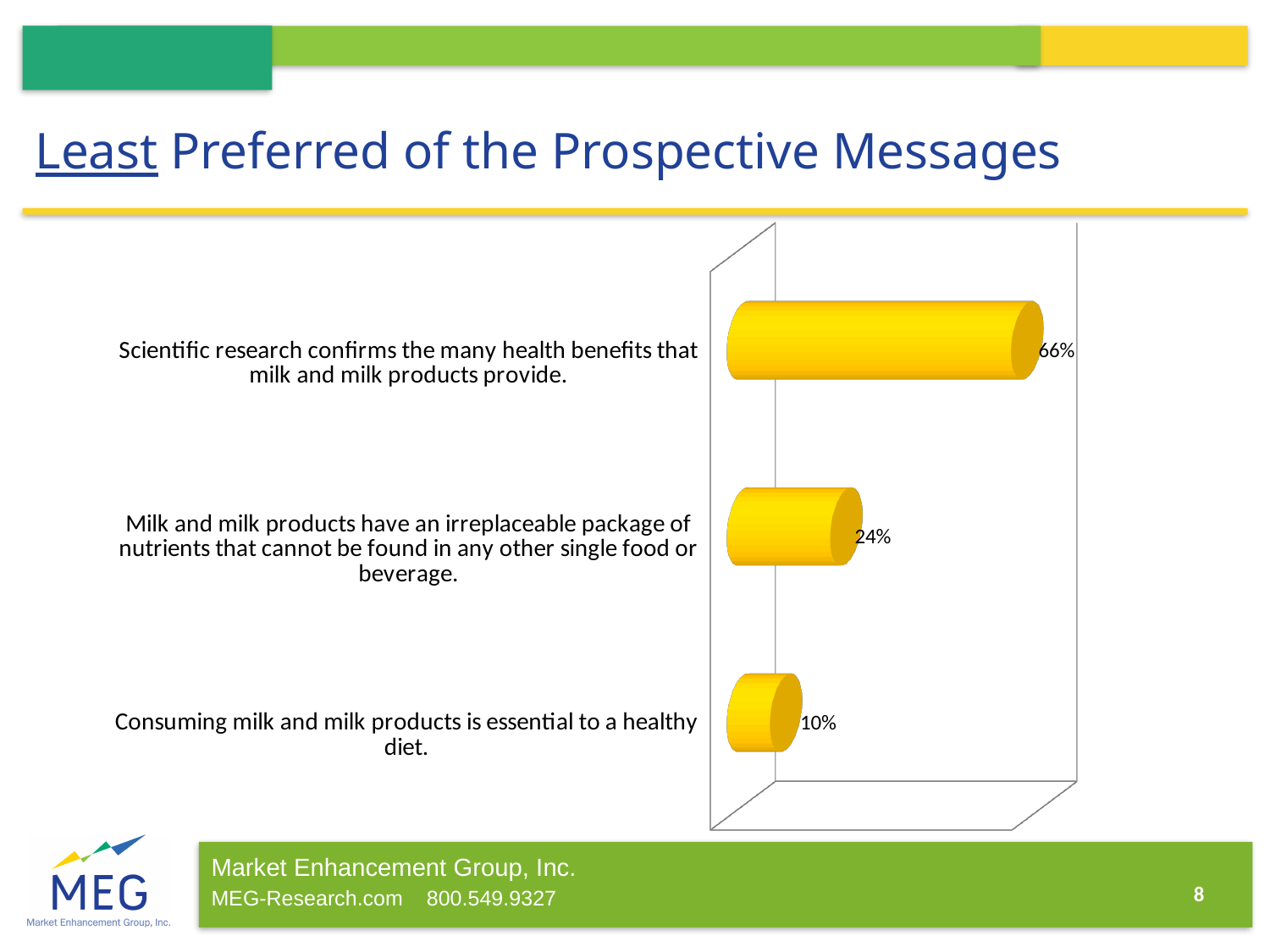
Which has a larger percentage: the "irreplaceable package of nutrients" message or the "essential to a healthy diet" message? Milk and milk products have an irreplaceable package of nutrients that cannot be found in any other single food or beverage. What percentage is shown for the message "Consuming milk and milk products is essential to a healthy diet."? 10% What is the difference in percentage points between the "Scientific research" message and the "irreplaceable package of nutrients" message? 42 What is the total of the three percentages shown in the chart? 100% What percentage is shown for the message "Milk and milk products have an irreplaceable package of nutrients that cannot be found in any other single food or beverage."? 24% What kind of chart is shown on the slide? Bar chart What is the difference in percentage points between the "irreplaceable package of nutrients" message and the "essential to a healthy diet" message? 14 Which message has the highest percentage? Scientific research confirms the many health benefits that milk and milk products provide. Which message has the lowest percentage? Consuming milk and milk products is essential to a healthy diet. How many messages are plotted in the chart? 3 What percentage is shown for the message "Scientific research confirms the many health benefits that milk and milk products provide."? 66% What is the title of the slide containing the chart? Least Preferred of the Prospective Messages